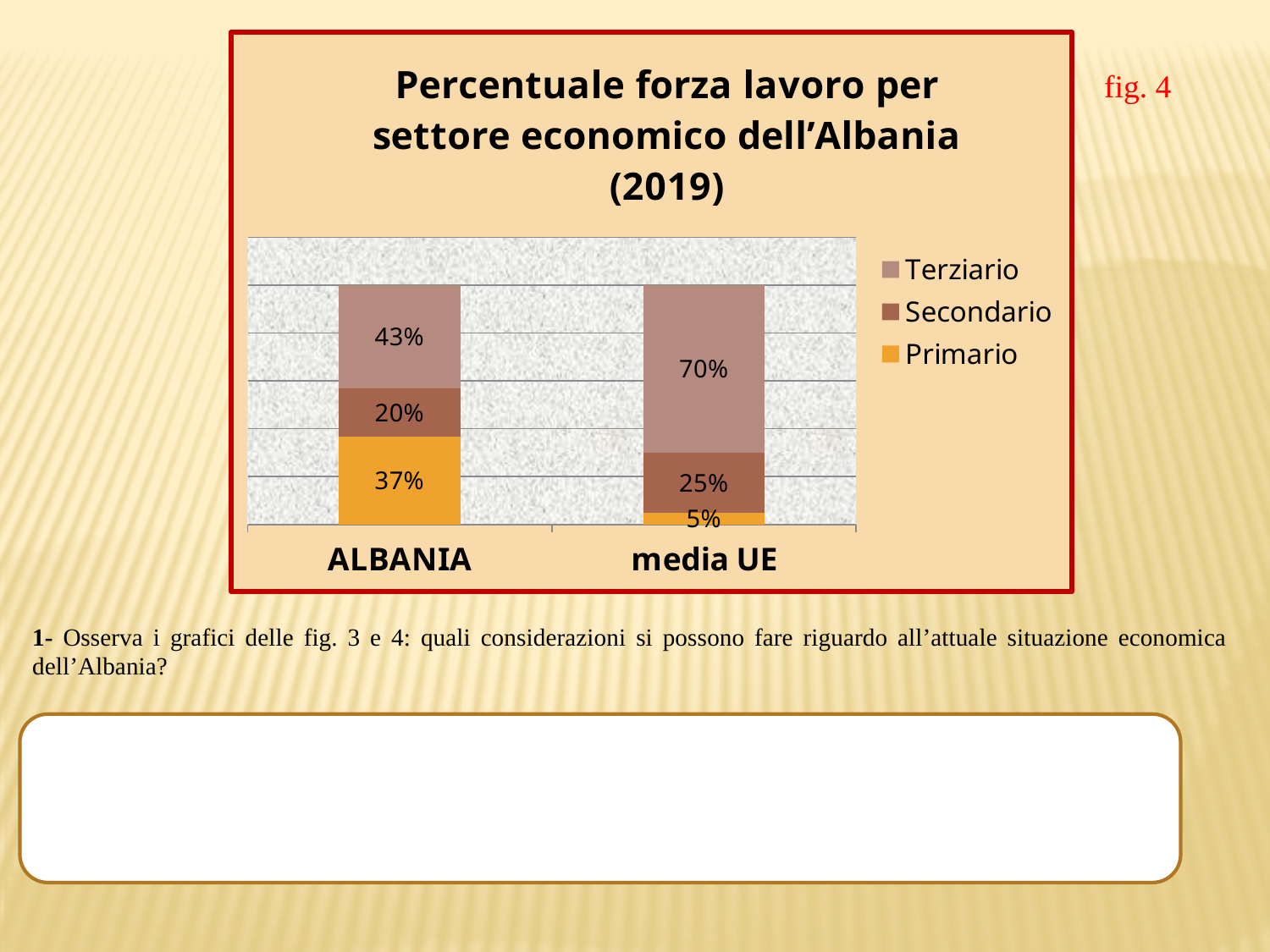
What is the total of the stacked bar for ALBANIA? 100% What is the Terziario value for media UE? 70% Which category has the lower Primario value? media UE What kind of chart is shown? Stacked bar chart How many series does the legend list? 3 What is the Secondario value for ALBANIA? 20% What is the Primario value for media UE? 5% What is the Primario value for ALBANIA? 37% Which category has the higher Terziario value, ALBANIA or media UE? media UE How many categories are shown on the x axis? 2 What is the difference between the Primario values for ALBANIA and media UE? 32% What is the difference between the Terziario values for media UE and ALBANIA? 27%